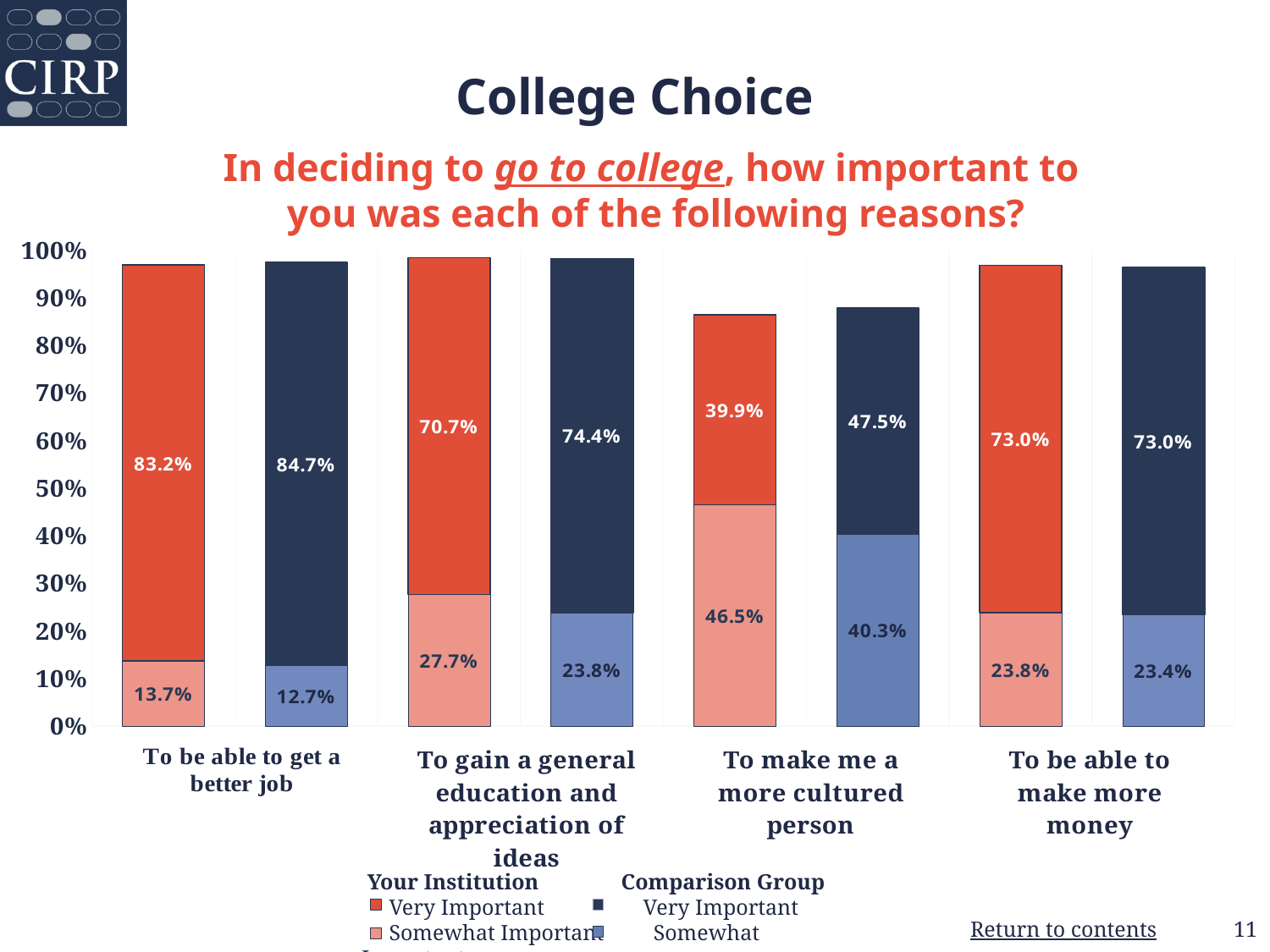
Which reason has the lowest Very Important percentage for Your Institution? To make me a more cultured person What is the combined Very Important and Somewhat Important total for Your Institution for "To be able to make more money"? 96.8% What is the Very Important percentage for the Comparison Group for "To gain a general education and appreciation of ideas"? 74.4% What percentage of Your Institution students rated "To be able to get a better job" as Very Important? 83.2% What percentage of the Comparison Group rated "To make me a more cultured person" as Somewhat Important? 40.3% How many reasons (categories) are shown on the x axis? 4 For "To gain a general education and appreciation of ideas", which is larger: the Somewhat Important percentage for Your Institution or for the Comparison Group? Your Institution What is the difference between the Comparison Group and Your Institution Very Important percentages for "To make me a more cultured person"? 7.6% What kind of chart is shown on the slide? Stacked bar chart Is the total stacked bar for Your Institution for "To make me a more cultured person" greater or less than 90%? less How many series does the legend list? 4 Which reason has the highest Very Important percentage for the Comparison Group? To be able to get a better job